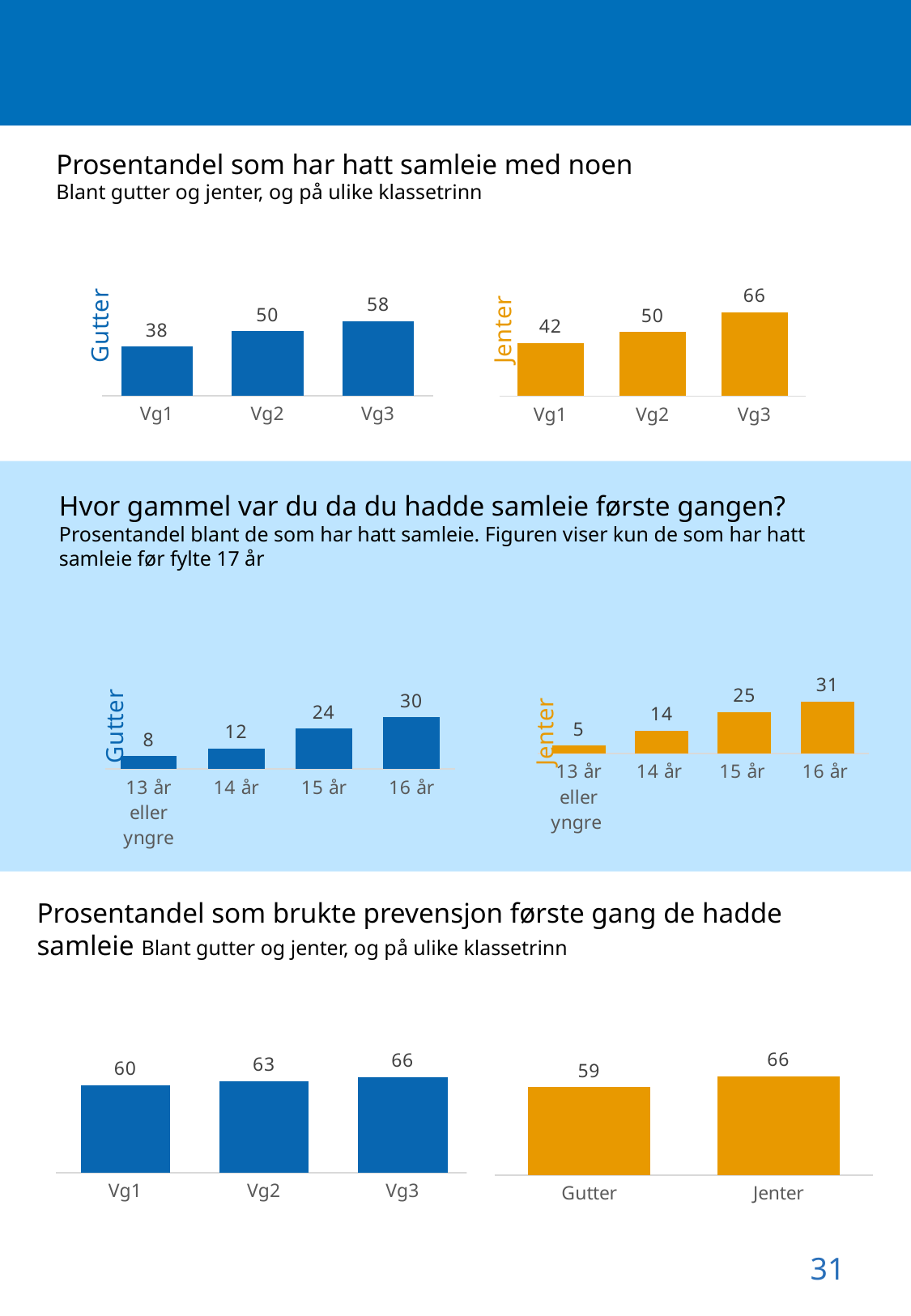
In the top 'Prosentandel som har hatt samleie med noen' chart for Jenter, what is the value for Vg3? 66 In the top 'Prosentandel som har hatt samleie med noen' charts, do the values rise or fall from Vg1 to Vg3 for Gutter? rise In the middle 'Hvor gammel var du da du hadde samleie første gangen?' chart for Gutter, what is the value for 15 år? 24 In the bottom 'Prosentandel som brukte prevensjon første gang de hadde samleie' chart by class level, what is the value for Vg2? 63 In the top 'Prosentandel som har hatt samleie med noen' charts, what is the difference between the Jenter Vg3 value and the Gutter Vg3 value? 8 What kind of chart is used in the bottom 'Prosentandel som brukte prevensjon første gang de hadde samleie' section? bar chart In the middle 'Hvor gammel var du da du hadde samleie første gangen?' chart for Gutter, how many age categories are shown? 4 In the top 'Prosentandel som har hatt samleie med noen' chart for Gutter, which class level has the lowest value? Vg1 In the middle 'Hvor gammel var du da du hadde samleie første gangen?' chart for Jenter, which age category has the highest value? 16 år In the middle 'Hvor gammel var du da du hadde samleie første gangen?' chart for Jenter, what is the value for 13 år eller yngre? 5 In the bottom 'Prosentandel som brukte prevensjon første gang de hadde samleie' chart by gender, which is larger, Gutter or Jenter? Jenter In the top 'Prosentandel som har hatt samleie med noen' chart for Gutter, what is the value for Vg2? 50